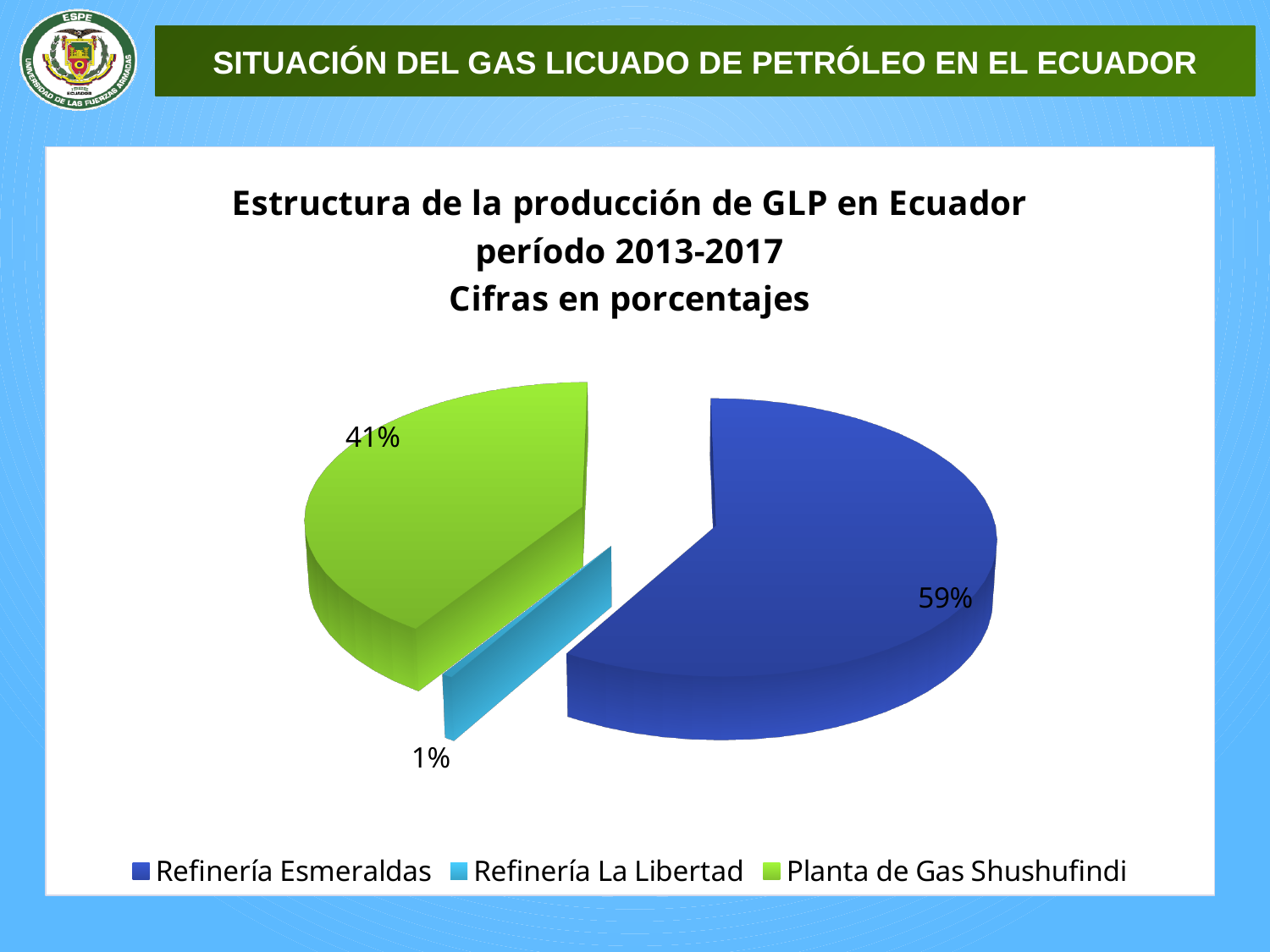
How many slices does the pie chart have? 3 What percentage of GLP production corresponds to Planta de Gas Shushufindi? 41% What type of chart is shown on the slide? Pie chart What is the difference in percentage points between Refinería Esmeraldas and Planta de Gas Shushufindi? 18 What percentage of GLP production corresponds to Refinería La Libertad? 1% What period does the chart title say the data covers? 2013-2017 Which producer has the smallest share of GLP production? Refinería La Libertad Which has a larger share, Planta de Gas Shushufindi or Refinería La Libertad? Planta de Gas Shushufindi Which producer has the largest share of GLP production? Refinería Esmeraldas Which colour represents Refinería La Libertad in the chart? Light blue What percentage of GLP production corresponds to Refinería Esmeraldas? 59% How many entries does the legend list? 3